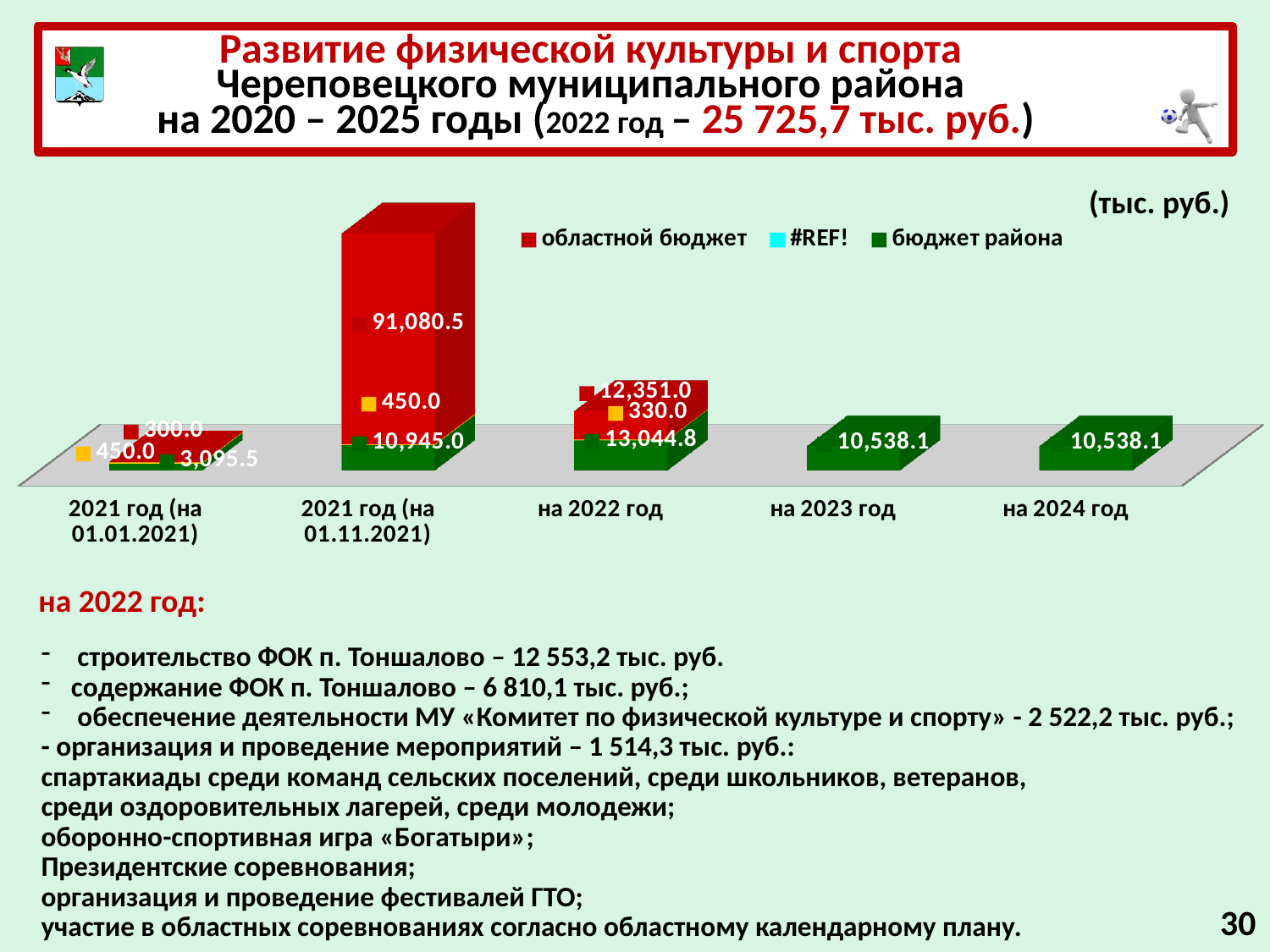
Which category has the highest value for областной бюджет? 2021 год (на 01.11.2021) What is the difference between the областной бюджет values for на 2022 год and 2021 год (на 01.01.2021)? 12,051.0 What is the value of бюджет района for на 2023 год? 10,538.1 What is the difference between the бюджет района values for на 2022 год and на 2023 год? 2,506.7 Which has the larger бюджет района value: 2021 год (на 01.11.2021) or на 2022 год? на 2022 год What is the value of бюджет района for на 2022 год? 13,044.8 How many series does the chart legend list? 3 What is the value of областной бюджет for 2021 год (на 01.01.2021)? 300.0 How many categories are shown on the x axis of the chart? 5 What is the value of областной бюджет for 2021 год (на 01.11.2021)? 91,080.5 Which category has the lowest value for бюджет района? 2021 год (на 01.01.2021) What kind of chart is shown on the slide? bar chart